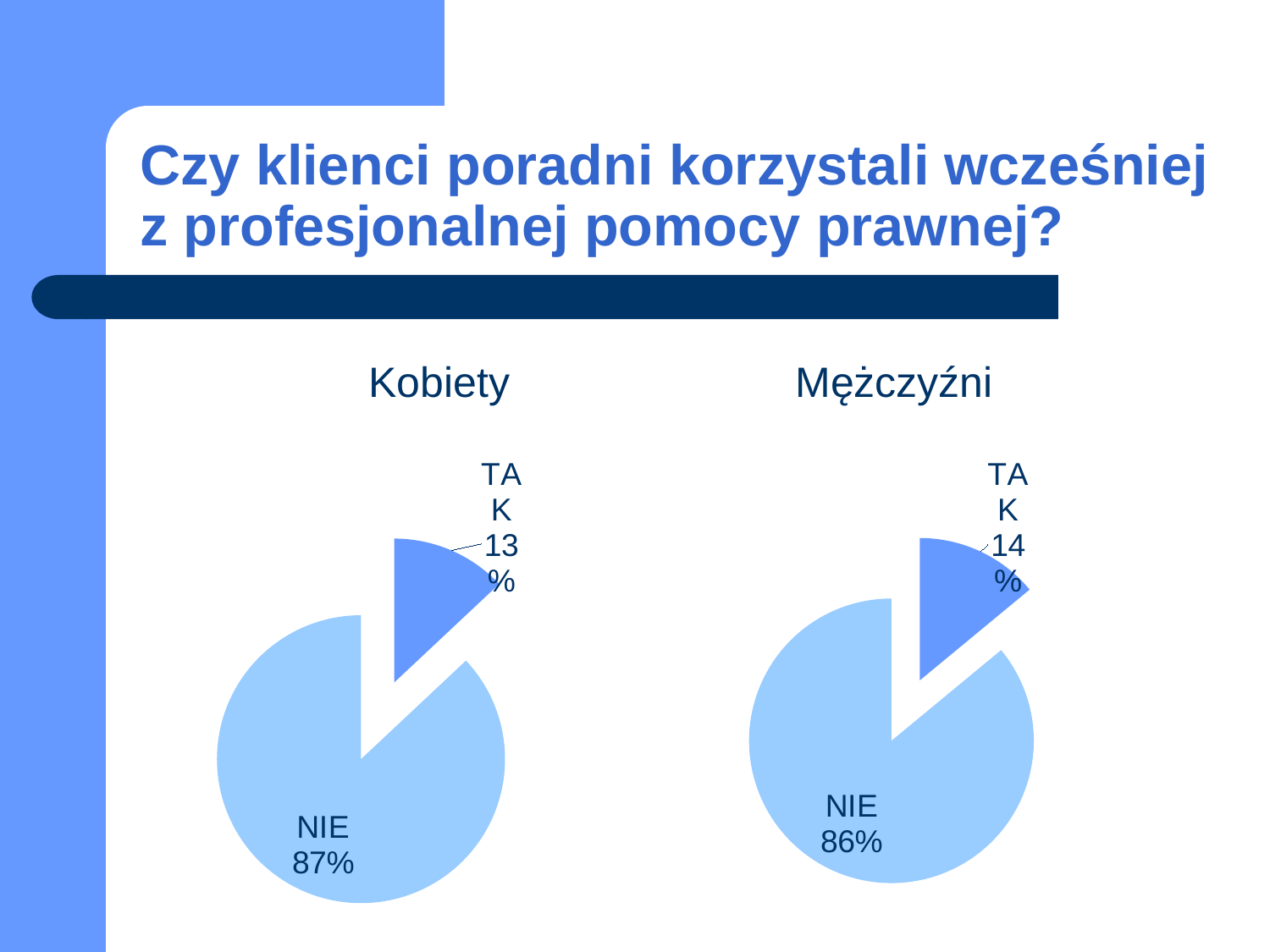
In the Mężczyźni chart, which slice is the smallest? TAK In the Mężczyźni chart, what is the difference between the NIE and TAK percentages? 72% What type of chart is the Mężczyźni chart? Pie chart In the Mężczyźni chart, what percentage is shown for TAK? 14% In the Kobiety chart, which slice is the largest? NIE What is the title of the chart on the left? Kobiety In the Kobiety chart, what percentage is shown for TAK? 13% Which is larger: the TAK share in the Kobiety chart or the TAK share in the Mężczyźni chart? Mężczyźni In the Mężczyźni chart, what percentage is shown for NIE? 86% In the Kobiety chart, what percentage is shown for NIE? 87% In the Kobiety chart, what is the difference between the NIE and TAK percentages? 74% How many slices does the Kobiety chart have? 2